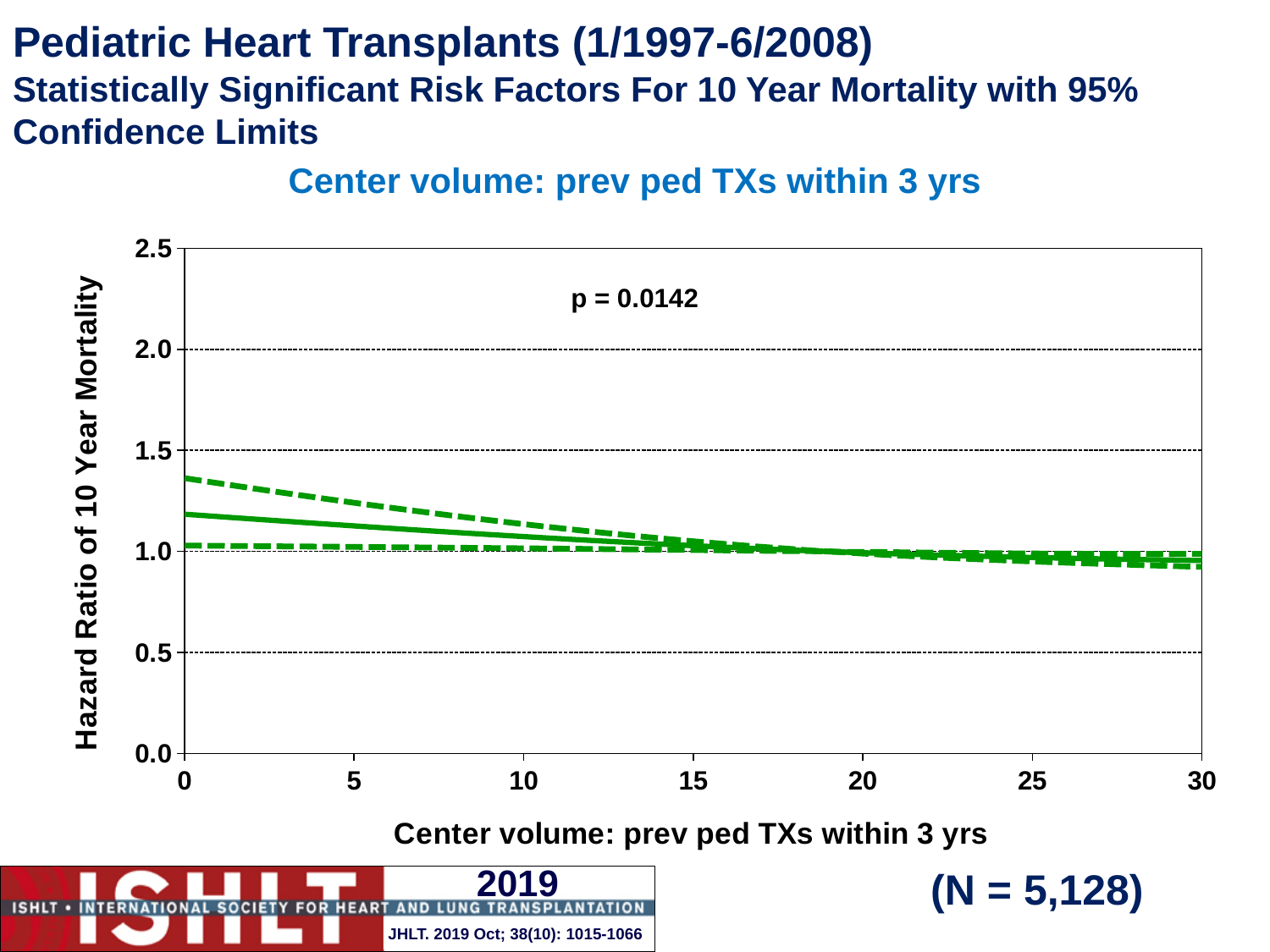
How many lines are plotted on the chart? 3 What kind of chart is shown on the slide? line chart What is the label of the y axis? Hazard Ratio of 10 Year Mortality Does the hazard ratio (solid line) rise or fall as center volume increases from 0 to 30? fall Is the upper confidence limit (upper dashed line) at a center volume of 0 greater or less than 1.5? less Is the upper confidence limit (upper dashed line) at a center volume of 0 greater or less than 1.0? greater What is the highest value shown on the y axis? 2.5 Is the hazard ratio (solid line) at a center volume of 30 greater or less than 1.5? less What is the highest value shown on the x axis? 30 What p-value is printed on the chart? p = 0.0142